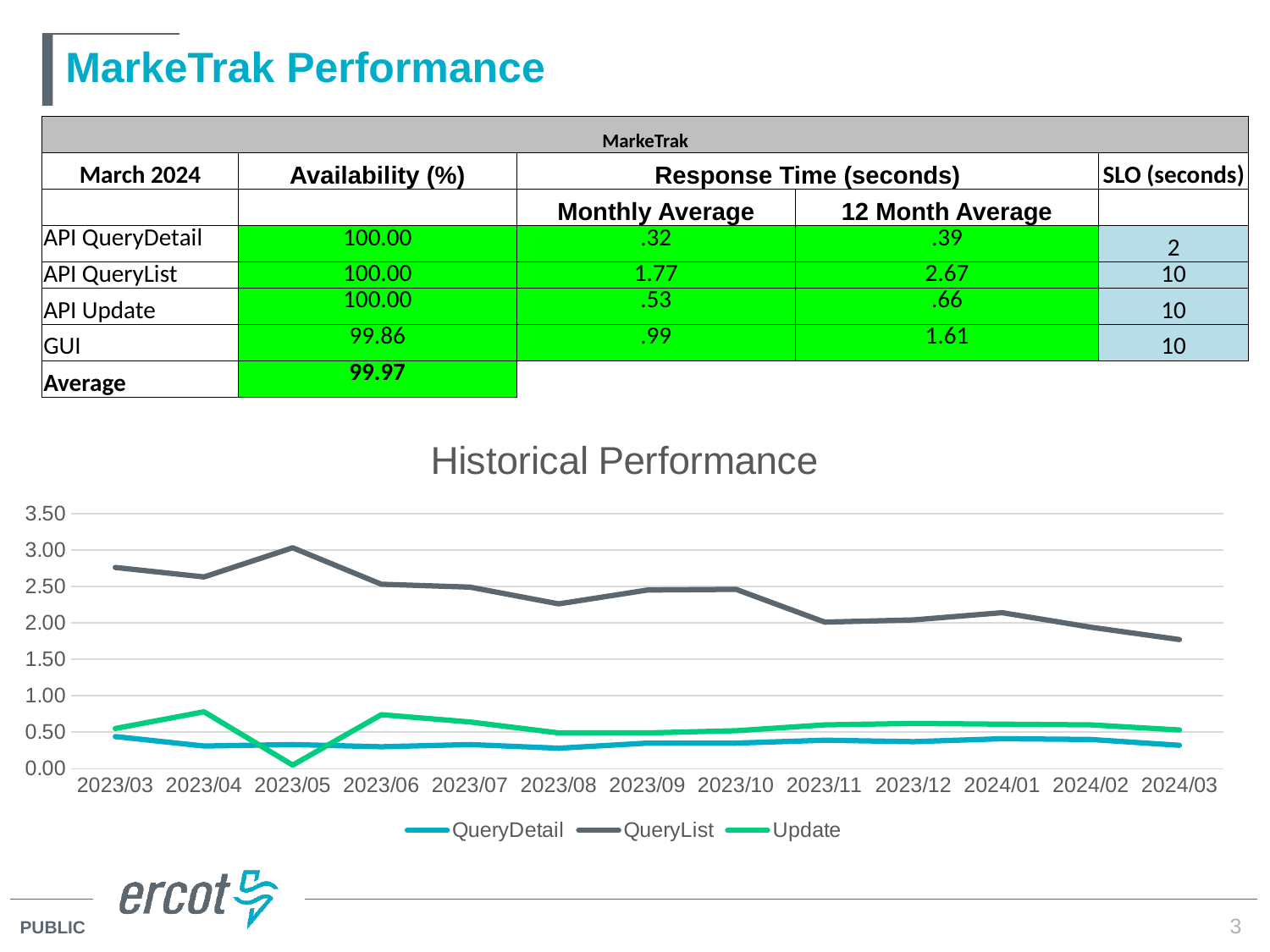
In the Historical Performance chart, in which month does the Update series reach its lowest value? 2023/05 How many series does the legend of the Historical Performance chart list? 3 How many months are plotted along the x axis of the Historical Performance chart? 13 What is the title of the chart on the slide? Historical Performance In the Historical Performance chart, is the Update value for 2023/04 greater or less than 0.50? greater In the Historical Performance chart, in which month does the QueryList series reach its lowest value? 2024/03 In the Historical Performance chart, does the QueryList series generally rise or fall from 2023/03 to 2024/03? fall In the Historical Performance chart, in which month does the QueryList series reach its highest value? 2023/05 In the Historical Performance chart, is the QueryList value for 2024/03 greater or less than 2.00? less What kind of chart is the Historical Performance chart? line chart In the Historical Performance chart, which series is higher in 2023/10, QueryList or QueryDetail? QueryList In the Historical Performance chart, is the QueryList value for 2023/03 greater or less than 2.50? greater